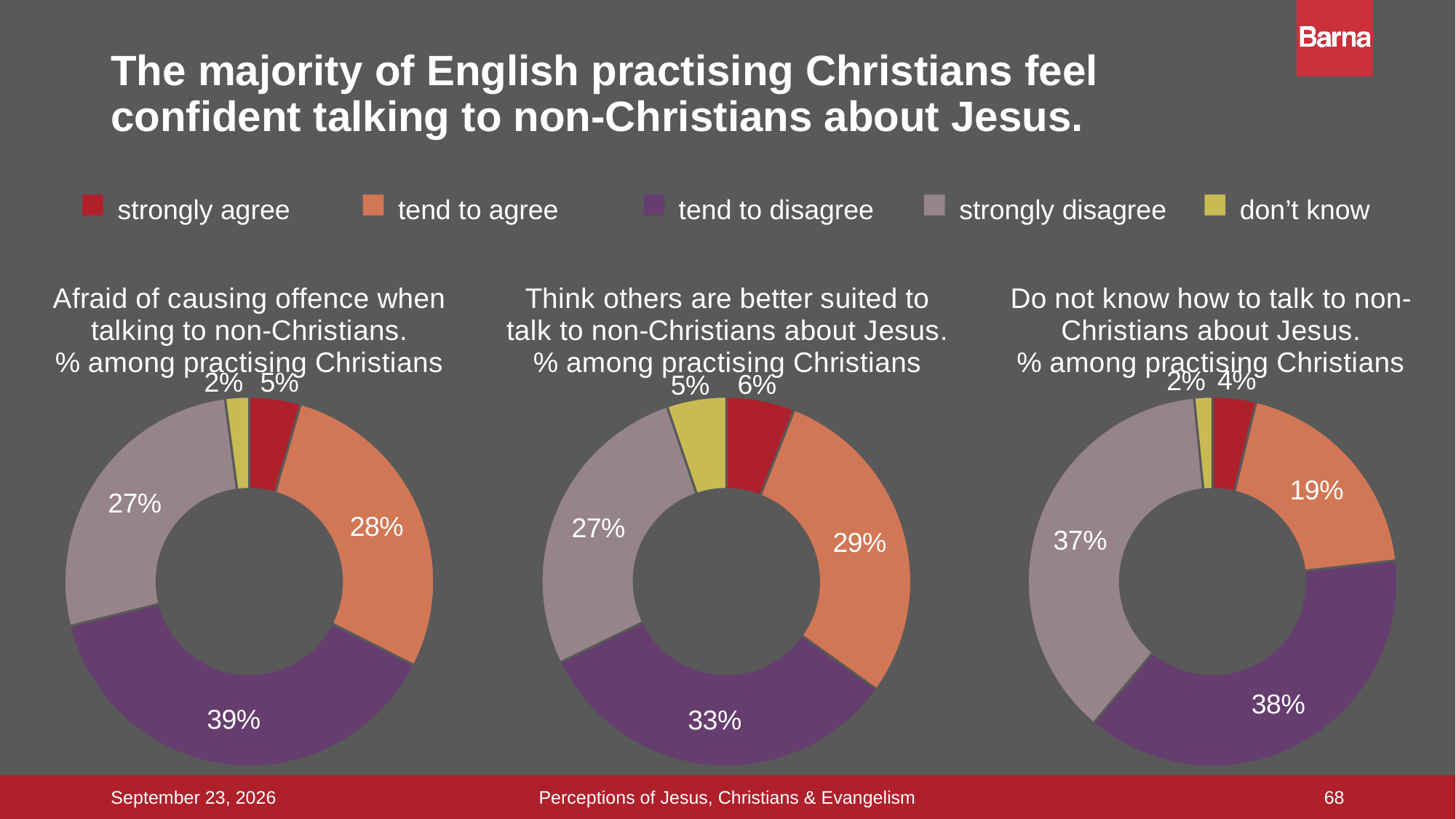
In the middle chart (Think others are better suited to talk to non-Christians about Jesus), what percentage answered don't know? 5% What kind of chart is used on this slide? Pie (doughnut) chart In the middle chart (Think others are better suited to talk to non-Christians about Jesus), what percentage tend to agree? 29% In the right chart (Do not know how to talk to non-Christians about Jesus), what percentage tend to agree? 19% In the middle chart (Think others are better suited to talk to non-Christians about Jesus), which response has the smallest share? don't know In the middle chart (Think others are better suited to talk to non-Christians about Jesus), which is larger: tend to disagree or strongly disagree? tend to disagree How many series does the legend list? 5 In the right chart (Do not know how to talk to non-Christians about Jesus), what percentage strongly disagree? 37% In the left chart (Afraid of causing offence when talking to non-Christians), what percentage strongly agree? 5% In the left chart (Afraid of causing offence when talking to non-Christians), which response has the largest share? tend to disagree In the left chart (Afraid of causing offence when talking to non-Christians), what percentage tend to disagree? 39% In the right chart (Do not know how to talk to non-Christians about Jesus), what is the difference between the tend to disagree and tend to agree shares? 19%